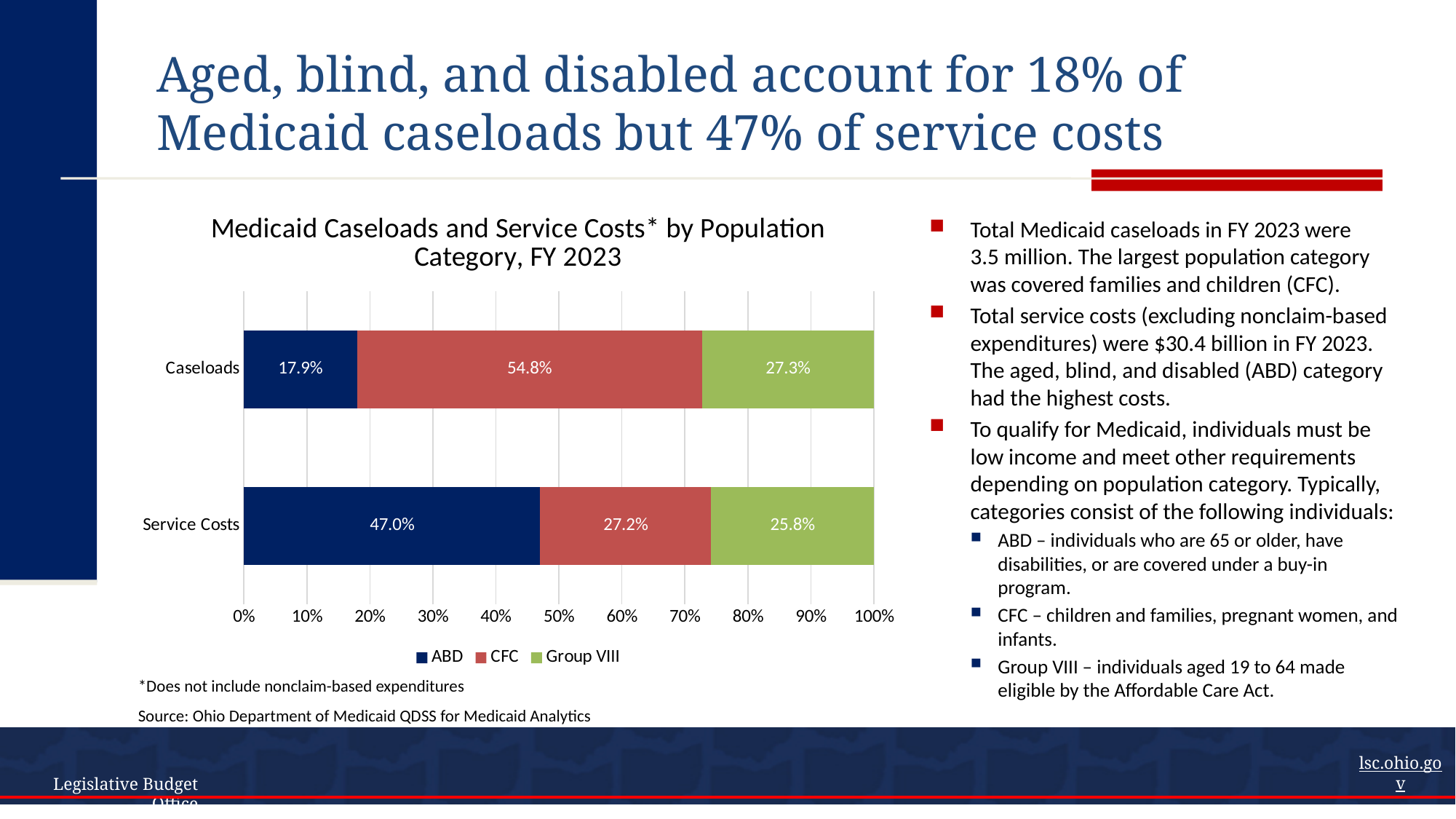
How many series does the legend list? 3 Which population category has the smallest share of Service Costs? Group VIII What is the difference between the ABD share of Service Costs and the ABD share of Caseloads? 29.1% What share of Caseloads is ABD? 17.9% What share of Caseloads is Group VIII? 27.3% What share of Service Costs is CFC? 27.2% What kind of chart is shown? Stacked bar chart What share of Service Costs is ABD? 47.0% What is the title of the chart? Medicaid Caseloads and Service Costs* by Population Category, FY 2023 How many bars are shown in the chart? 2 Which population category has the largest share of Caseloads? CFC Is the CFC share larger for Caseloads or for Service Costs? Caseloads